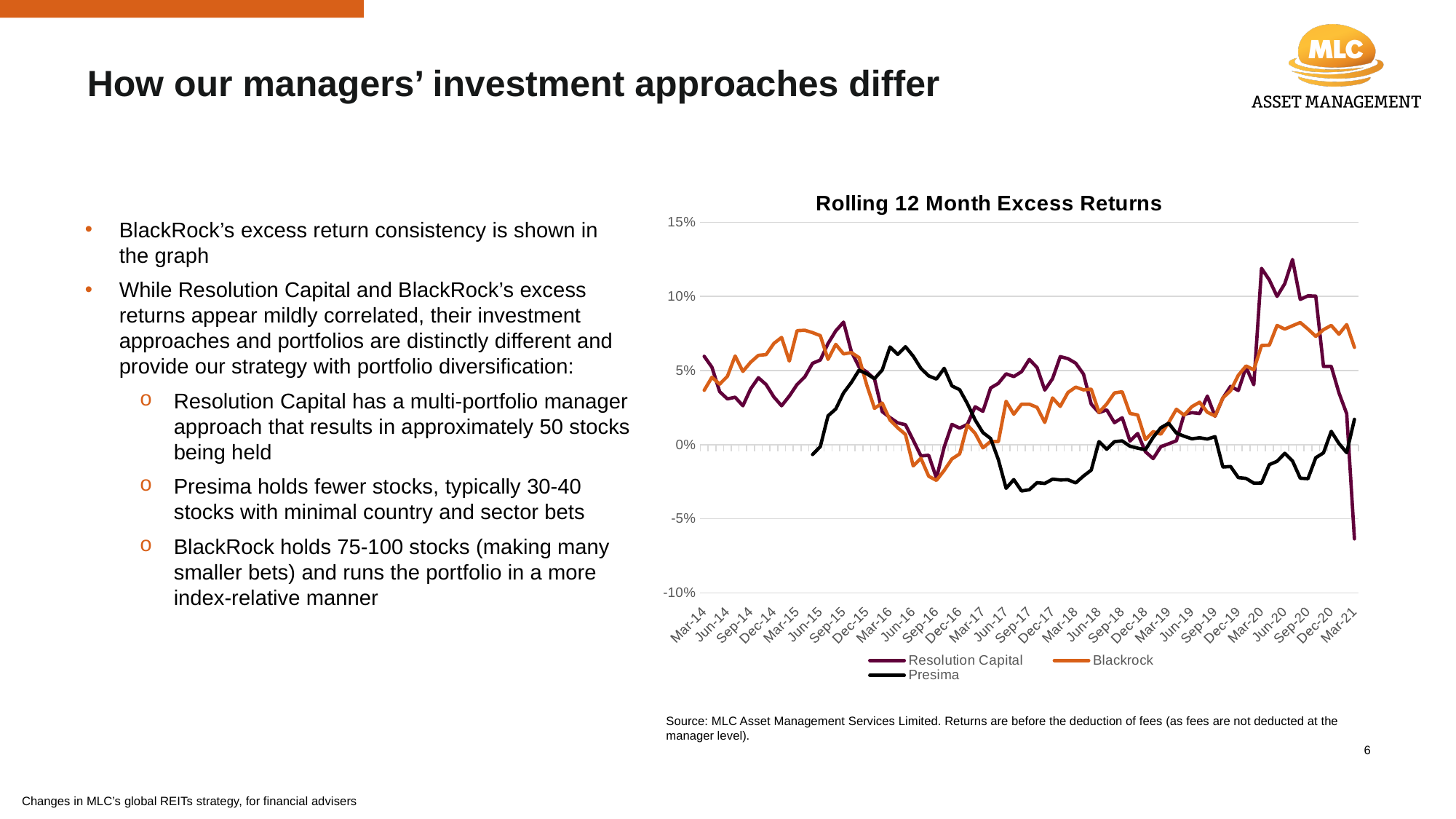
Is the peak value for Resolution Capital around Jun-20 greater or less than 10%? greater Is the value for Resolution Capital at Mar-21 greater or less than -5%? less Which series reaches the lowest value anywhere on the chart? Resolution Capital Which colour is used for the Blackrock line in the chart? orange At Mar-21, which series has the higher value, Blackrock or Resolution Capital? Blackrock Is the value for Presima at Jun-17 greater or less than 0%? less Does the Resolution Capital line rise or fall between Jun-20 and Mar-21? fall Which series reaches the highest value anywhere on the chart? Resolution Capital What is the title of the chart? Rolling 12 Month Excess Returns What kind of chart is shown on the slide? line chart How many series does the chart legend list? 3